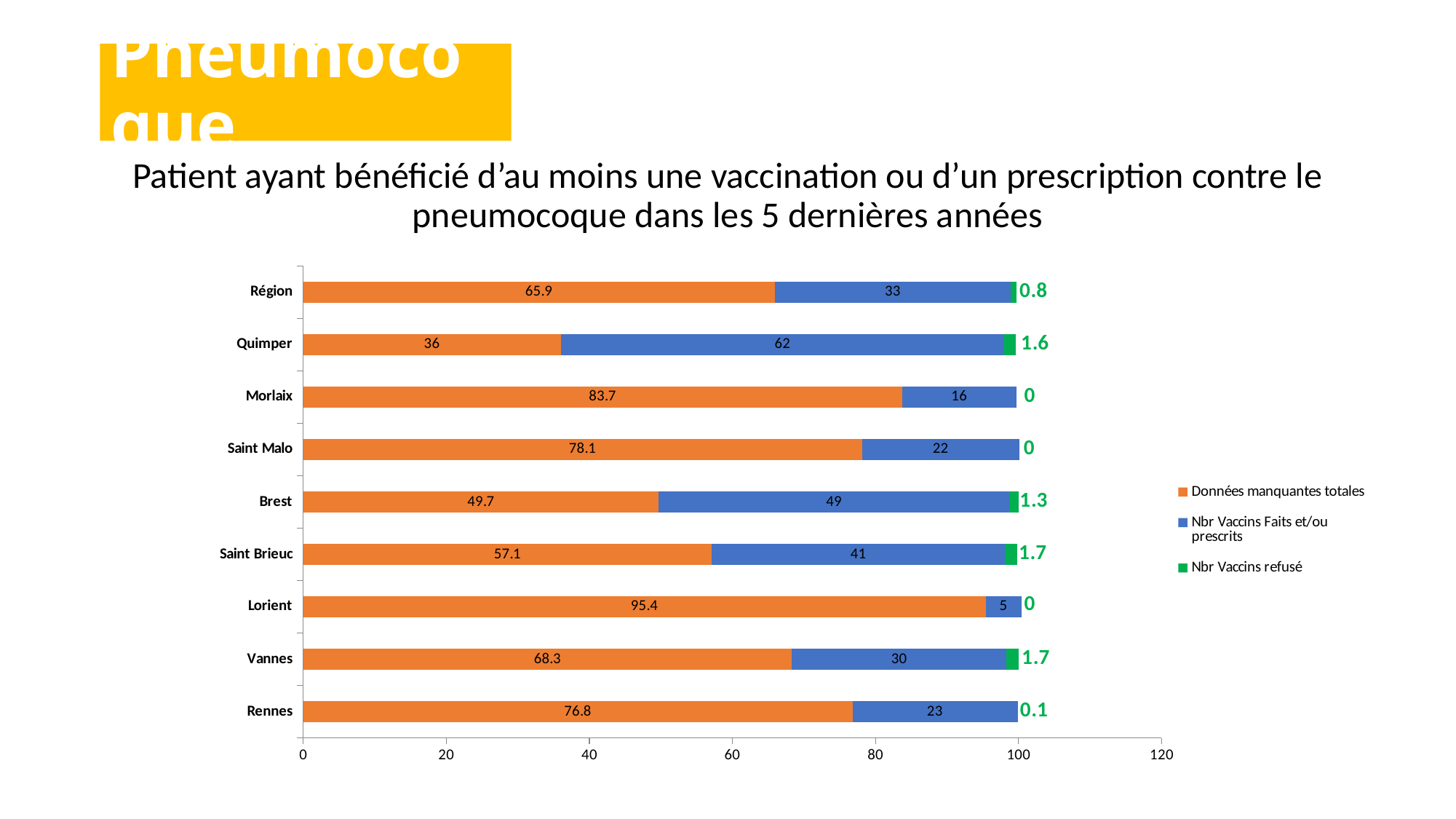
Which series is shown in green in the chart? Nbr Vaccins refusé Which category has the lowest value for Nbr Vaccins Faits et/ou prescrits? Lorient What kind of chart is shown on the slide? Stacked bar chart What is the value of Données manquantes totales for Lorient? 95.4 What is the value of Nbr Vaccins Faits et/ou prescrits for Quimper? 62 How many categories are shown on the y axis of the chart? 9 What is the value of Nbr Vaccins refusé for Saint Brieuc? 1.7 Which has a larger Nbr Vaccins Faits et/ou prescrits value, Brest or Vannes? Brest What is the total of the stacked bar for Morlaix? 99.7 Which category has the highest value for Données manquantes totales? Lorient How many series does the legend list? 3 What is the difference between the Données manquantes totales values for Morlaix and Saint Malo? 5.6